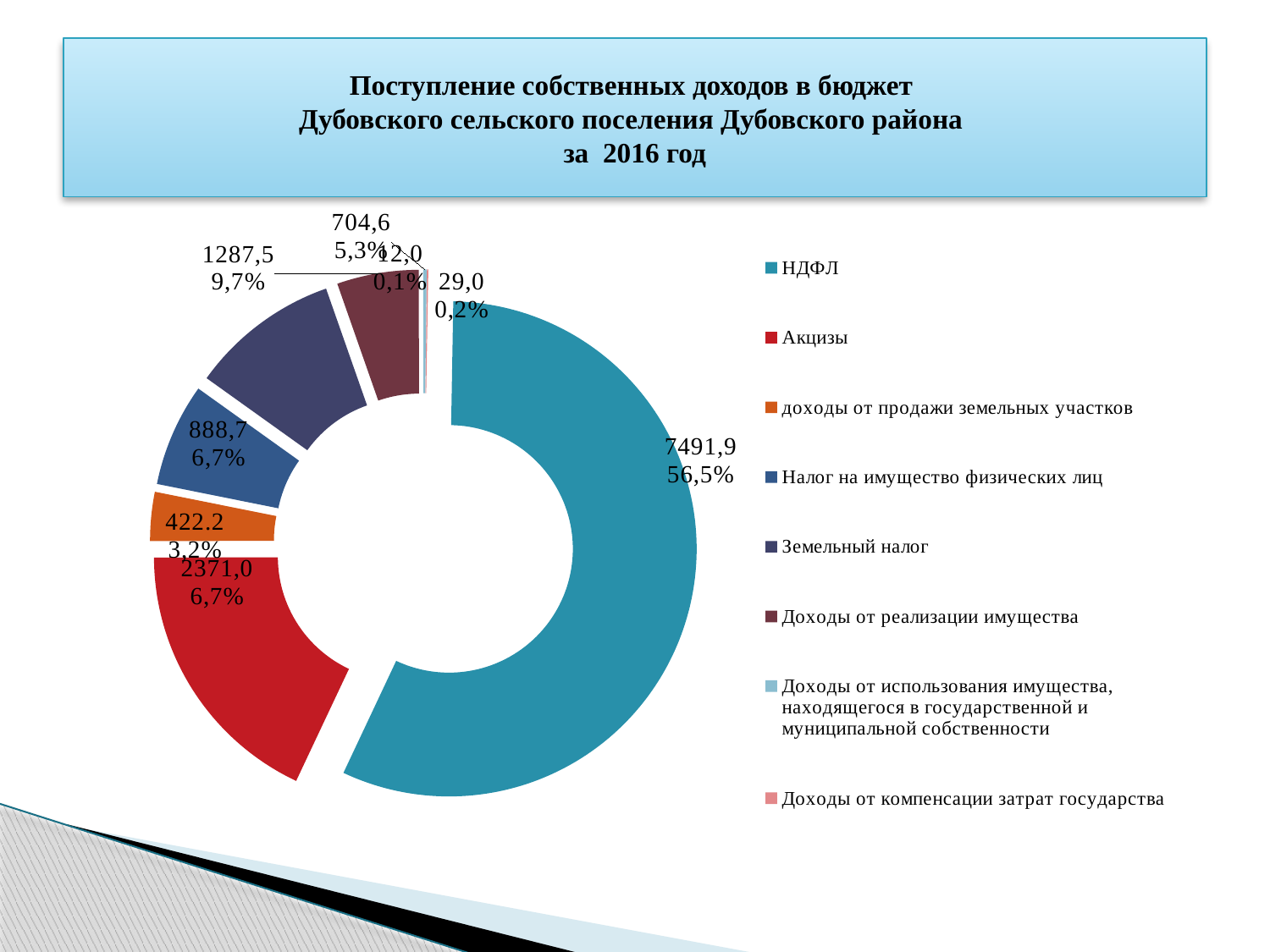
What kind of chart is shown on the slide? doughnut chart What is the value shown for Земельный налог? 1287,5 What is the value shown for НДФЛ? 7491,9 What is the value shown for Налог на имущество физических лиц? 888,7 Which category has the largest slice of the chart? НДФЛ What is the difference between the values for НДФЛ and Акцизы? 5120,9 Which is larger, the value for Земельный налог or the value for Налог на имущество физических лиц? Земельный налог What percentage is shown for Земельный налог? 9,7% What is the value shown for Доходы от реализации имущества? 704,6 What share of the total does НДФЛ account for? 56,5% How many entries does the legend list? 8 What is the value shown for Акцизы? 2371,0